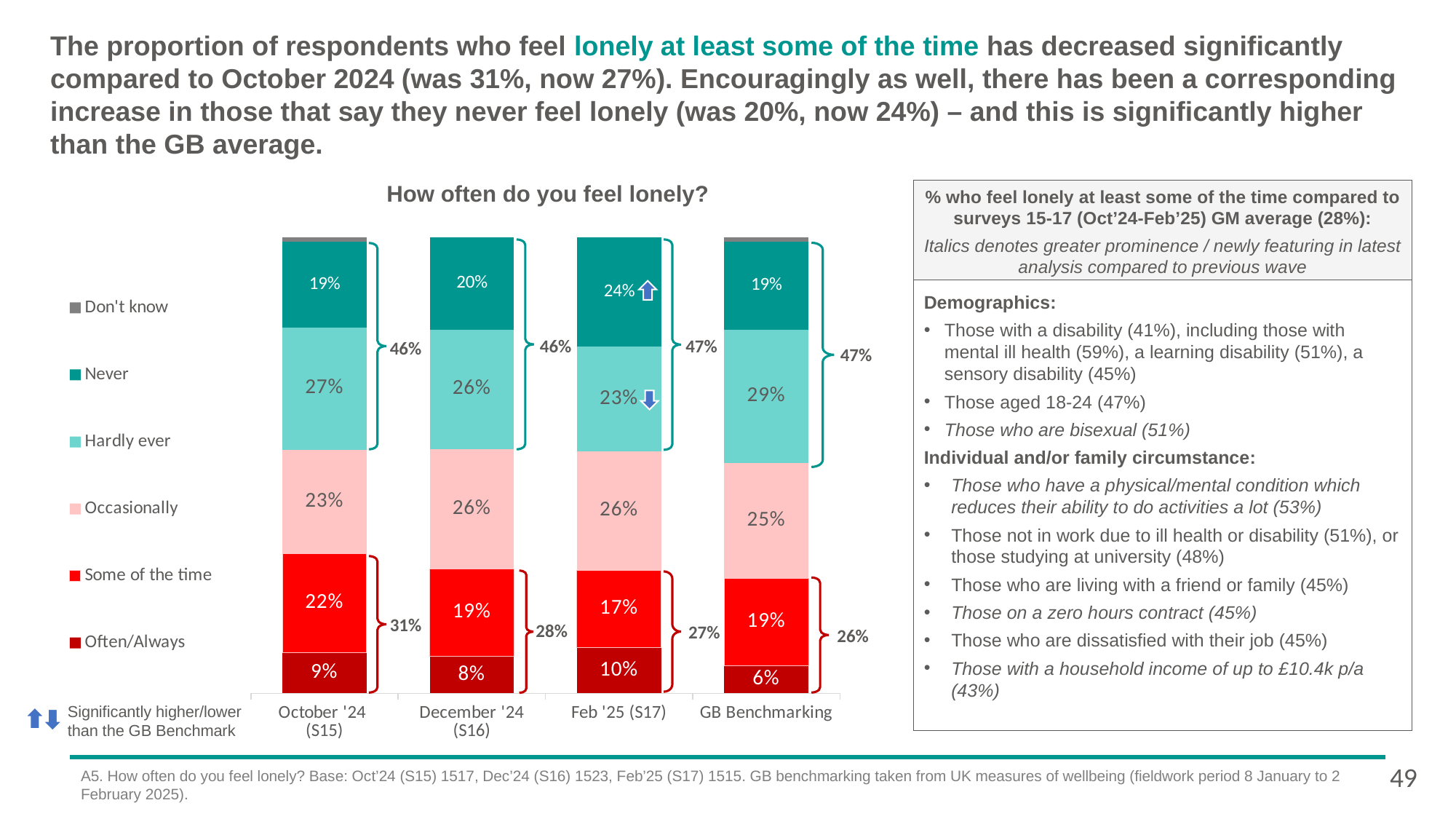
What is the title of the chart? How often do you feel lonely? What is the 'Hardly ever' value for October '24 (S15)? 27% What is the 'Never' value for Feb '25 (S17)? 24% How many bars (categories) are shown on the x axis? 4 What is the difference between the 'Some of the time' values for October '24 (S15) and Feb '25 (S17)? 5% What is the combined 'Some of the time' and 'Often/Always' total shown for December '24 (S16)? 28% What type of chart is shown on the slide? Stacked bar chart Which is larger: the 'Hardly ever' value for GB Benchmarking or for December '24 (S16)? GB Benchmarking Which bar has the highest 'Often/Always' value? Feb '25 (S17) Which bar has the lowest 'Some of the time' value? Feb '25 (S17) What is the 'Often/Always' value for GB Benchmarking? 6% How many series does the chart legend list? 6